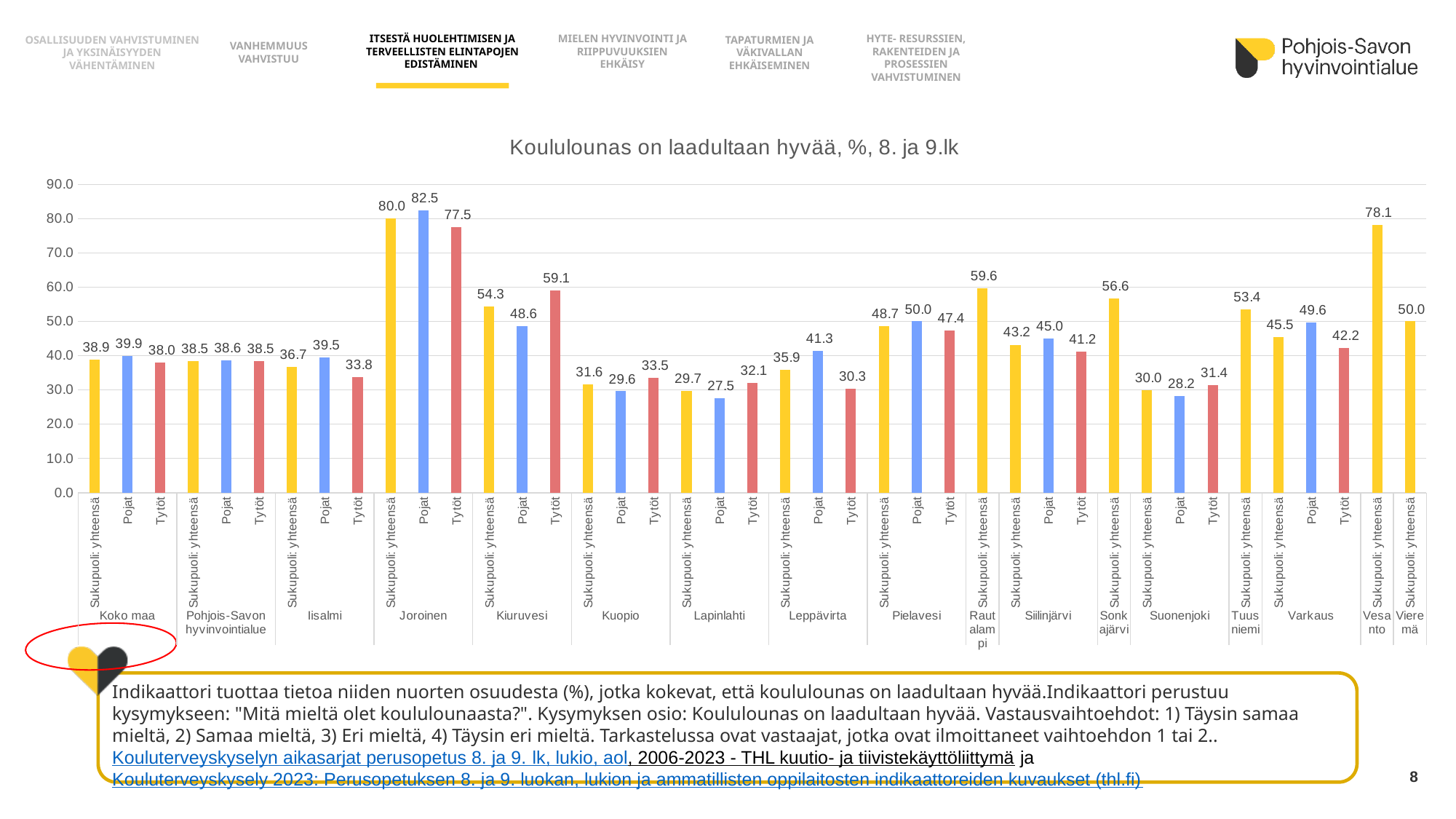
What kind of chart is shown on the slide? bar chart Is the Sukupuoli: yhteensä value for Sonkajärvi greater or less than 50.0? greater What is the value for Sukupuoli: yhteensä in Koko maa? 38.9 Which municipality has the lowest Sukupuoli: yhteensä value? Lapinlahti What is the difference between the Sukupuoli: yhteensä values for Joroinen and Pohjois-Savon hyvinvointialue? 41.5 Which municipality has the highest Sukupuoli: yhteensä value? Joroinen Which is larger in Kuopio, the Pojat value or the Tytöt value? Tytöt What is the value for Tytöt in Kiuruvesi? 59.1 What is the title of the chart? Koululounas on laadultaan hyvää, %, 8. ja 9.lk What is the value for Pojat in Joroinen? 82.5 What is the difference between the Pojat and Tytöt values in Leppävirta? 11.0 What is the value for Sukupuoli: yhteensä in Vesanto? 78.1